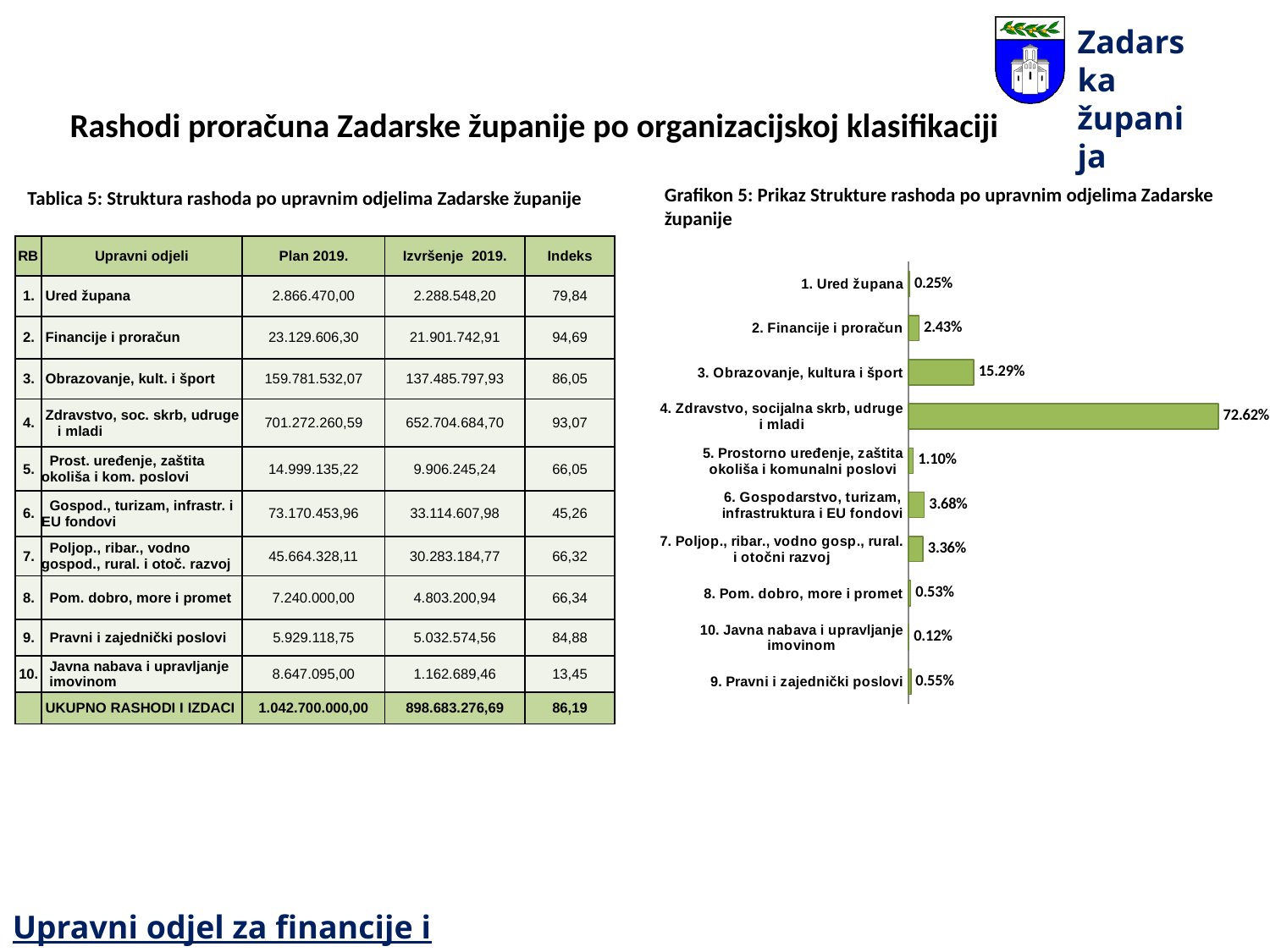
What is the value shown for "1. Ured župana"? 0.25% Which has a larger value: "2. Financije i proračun" or "6. Gospodarstvo, turizam, infrastruktura i EU fondovi"? 6. Gospodarstvo, turizam, infrastruktura i EU fondovi How many categories are shown in the chart? 10 What is the value shown for "6. Gospodarstvo, turizam, infrastruktura i EU fondovi"? 3.68% What is the value shown for "3. Obrazovanje, kultura i šport"? 15.29% What kind of chart is shown on the slide? Bar chart What is the title of the chart? Grafikon 5: Prikaz Strukture rashoda po upravnim odjelima Zadarske županije What is the difference between the values for "4. Zdravstvo, socijalna skrb, udruge i mladi" and "3. Obrazovanje, kultura i šport"? 57.33% What is the difference between the values for "3. Obrazovanje, kultura i šport" and "2. Financije i proračun"? 12.86% Which category has the lowest value in the chart? 10. Javna nabava i upravljanje imovinom What is the value shown for "4. Zdravstvo, socijalna skrb, udruge i mladi"? 72.62% Which category has the highest value in the chart? 4. Zdravstvo, socijalna skrb, udruge i mladi